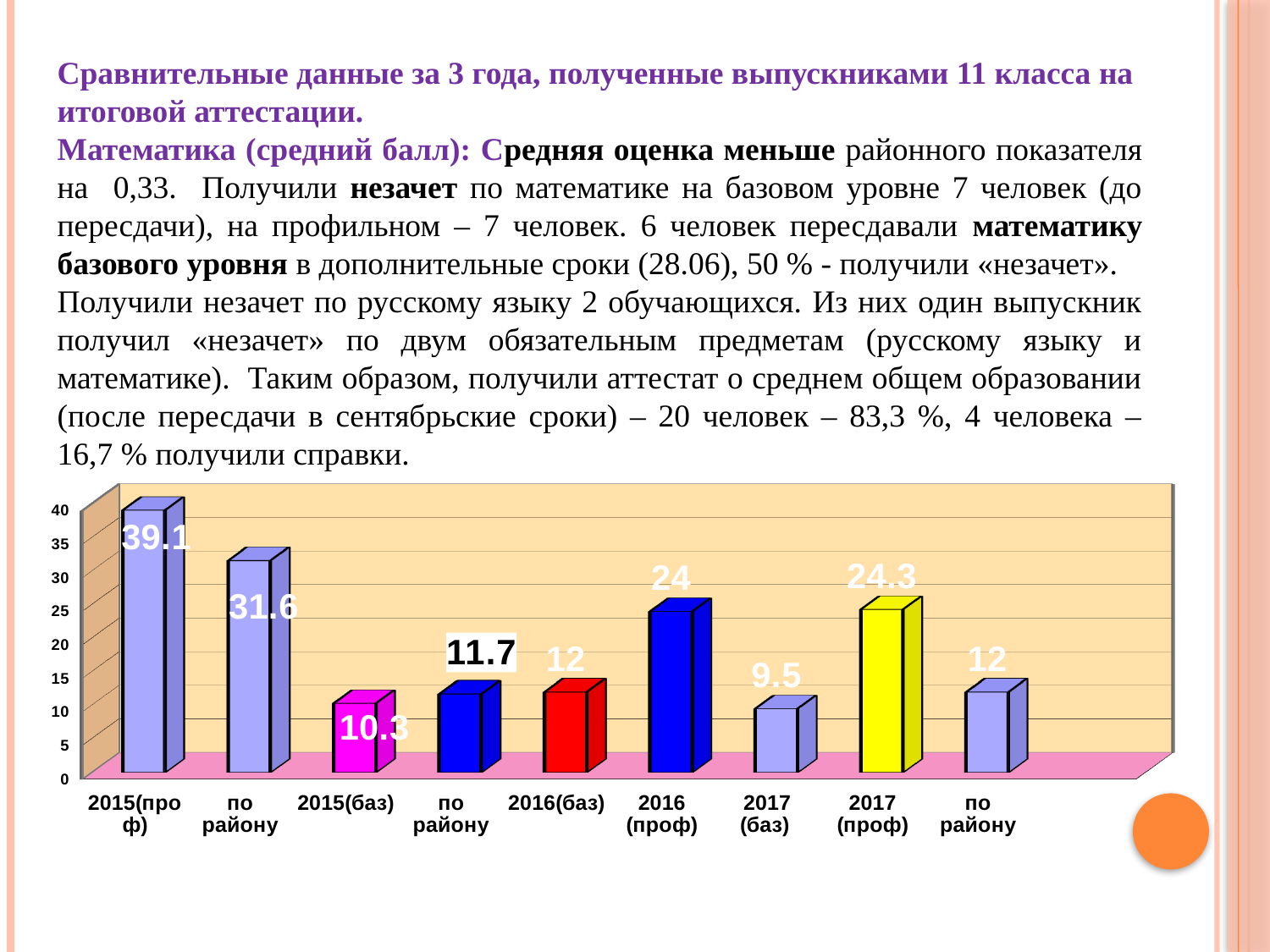
What is the value of the 2016 (проф) bar? 24 What is the value of the 2015(баз) bar? 10.3 What is the difference between the 2016 (проф) value and the 2016(баз) value? 12 Which category has the highest value in the chart? 2015(проф) How many bars are shown in the chart? 9 Which category has the lowest value in the chart? 2017 (баз) What is the value of the 2016(баз) bar? 12 Which is larger, the 2017 (проф) value or the 2016 (проф) value? 2017 (проф) What kind of chart is shown on the slide? bar chart What is the value of the 2015(проф) bar? 39.1 What is the value of the 2017 (проф) bar? 24.3 What is the value of the 2017 (баз) bar? 9.5